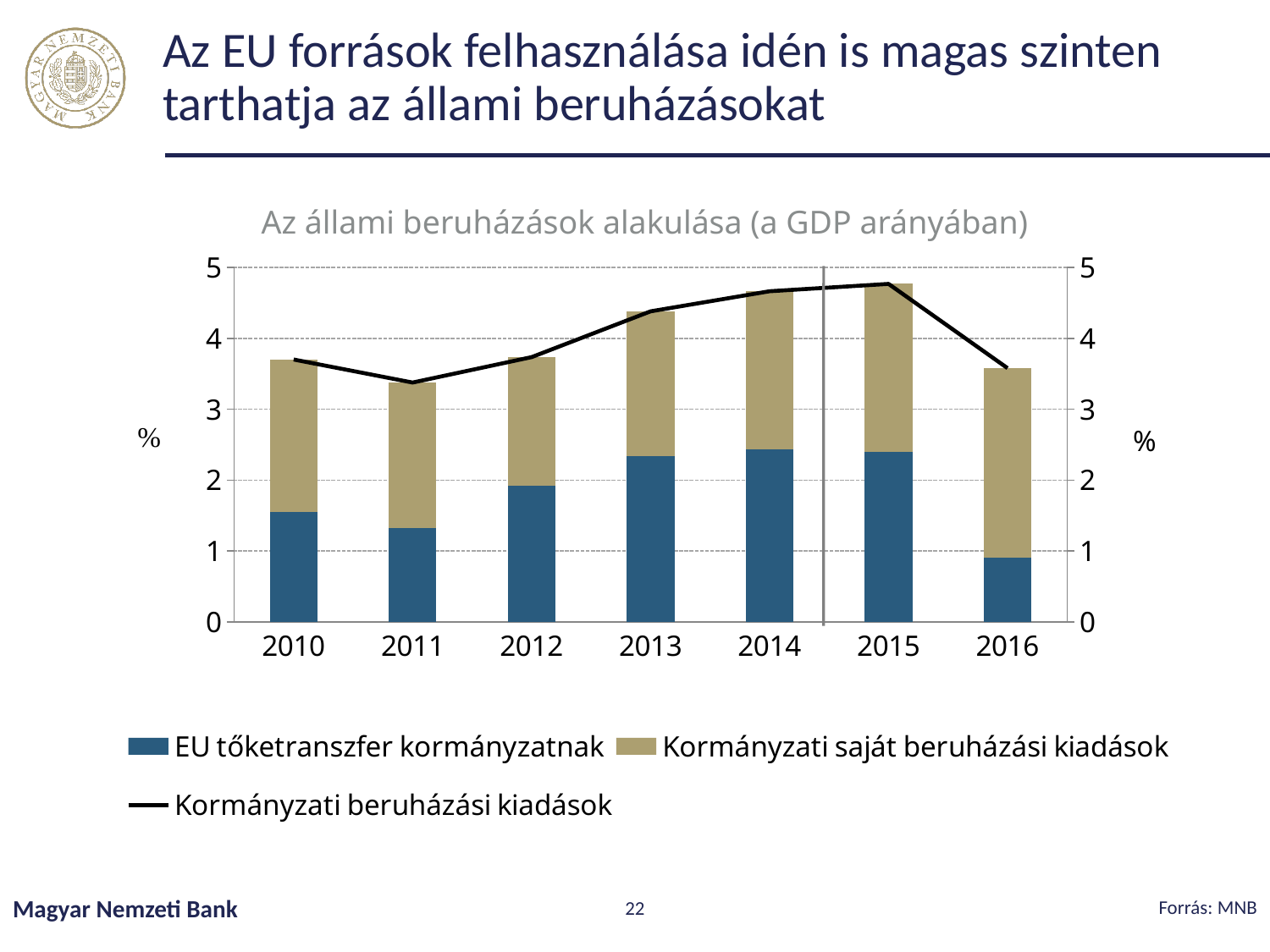
Is the total government investment (Kormányzati beruházási kiadások) for 2013 greater or less than 4? greater Is the value for EU tőketranszfer kormányzatnak in 2014 greater or less than 2? greater How many years are shown on the x axis? 7 How many series does the legend list? 3 Which year has the larger value for EU tőketranszfer kormányzatnak, 2011 or 2012? 2012 Is the value for EU tőketranszfer kormányzatnak in 2016 greater or less than 1? less What is the title of the chart? Az állami beruházások alakulása (a GDP arányában) Does the Kormányzati beruházási kiadások line rise or fall from 2011 to 2015? rise Which year has the larger total government investment, 2011 or 2013? 2013 Which year has the lowest value for EU tőketranszfer kormányzatnak? 2016 What kind of chart is shown on the slide? A stacked bar chart with a line